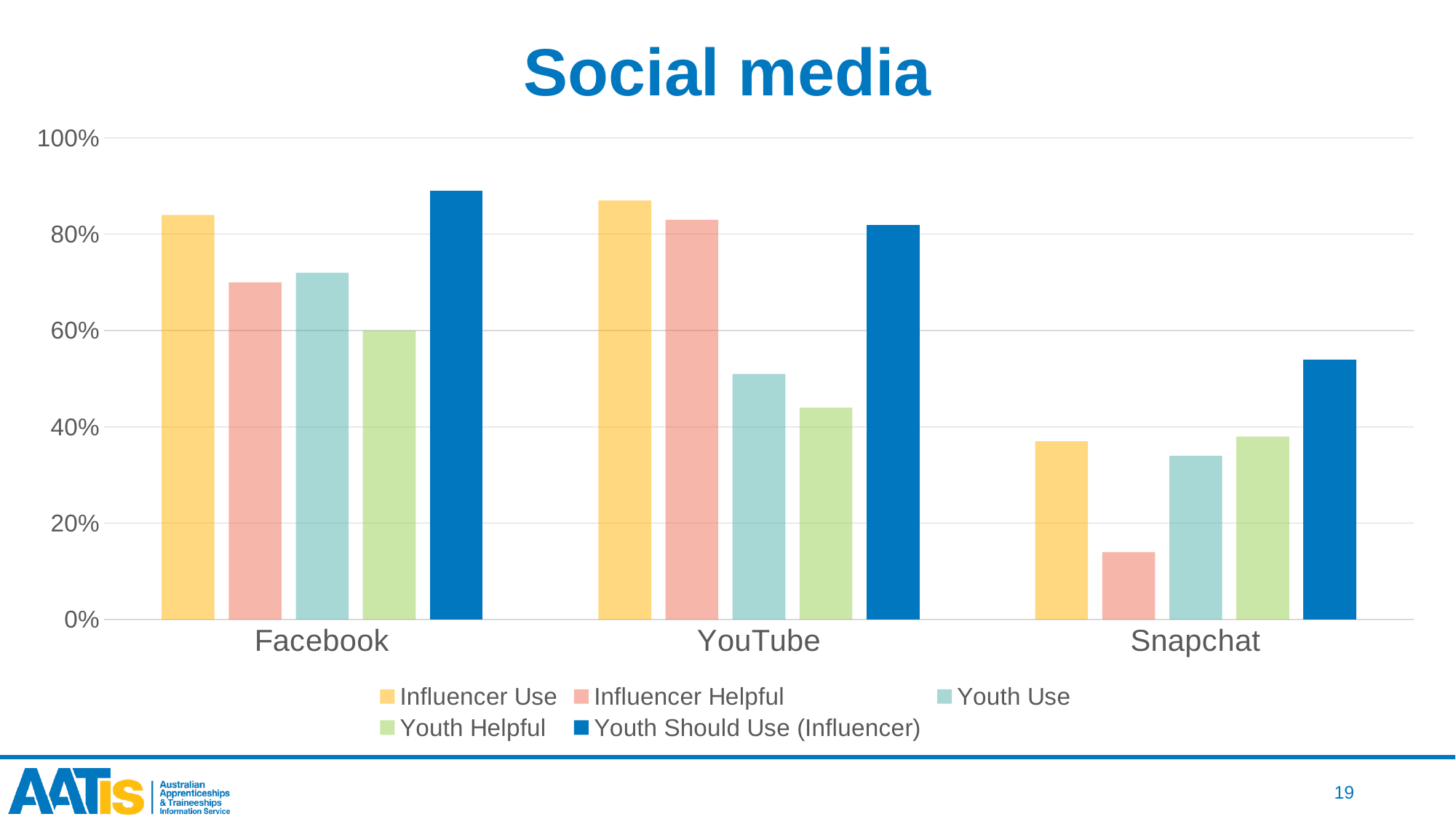
Is the Youth Should Use (Influencer) value for Facebook greater or less than 80%? greater Which series is shown in dark blue in the legend? Youth Should Use (Influencer) How many series does the legend list? 5 Which is larger: Youth Use for Facebook or Youth Use for YouTube? Youth Use for Facebook What is the title of the chart? Social media Is the Influencer Helpful value for Snapchat greater or less than 20%? less For YouTube, which series has the lowest value? Youth Helpful For Snapchat, which series has the lowest value? Influencer Helpful What kind of chart is shown on the slide? Bar chart For Snapchat, which series has the highest value? Youth Should Use (Influencer) How many social media platforms are shown on the x axis? 3 Do the Youth Should Use (Influencer) values rise or fall from Facebook to YouTube to Snapchat? fall